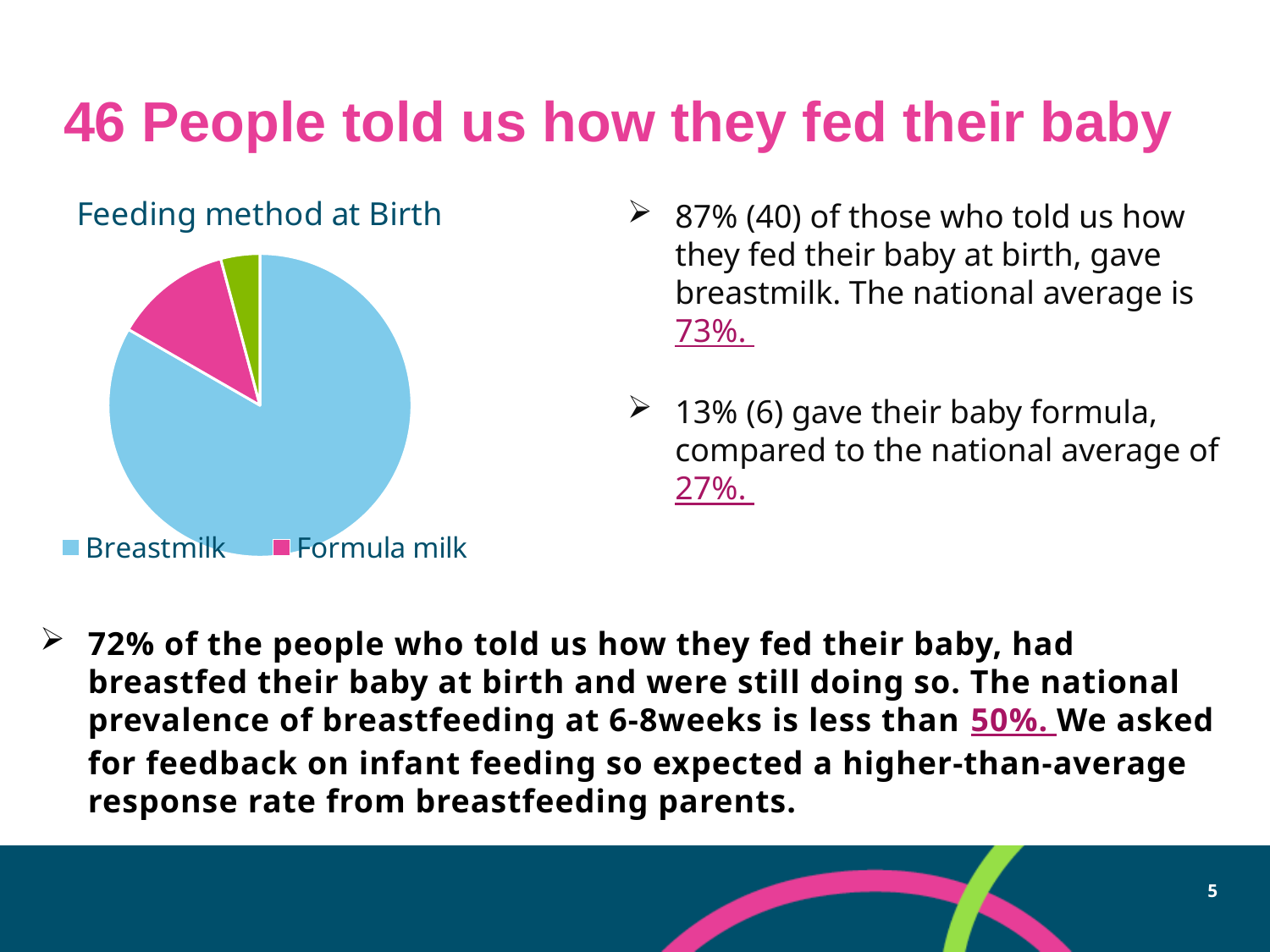
What is the title of the chart? Feeding method at Birth How many slices does the pie chart have? 3 What kind of chart is shown on the slide? pie chart What colour is the Formula milk slice in the pie chart? pink Which slice is larger, Breastmilk or Formula milk? Breastmilk Which feeding method has the largest slice of the pie? Breastmilk How many entries does the chart's legend list? 2